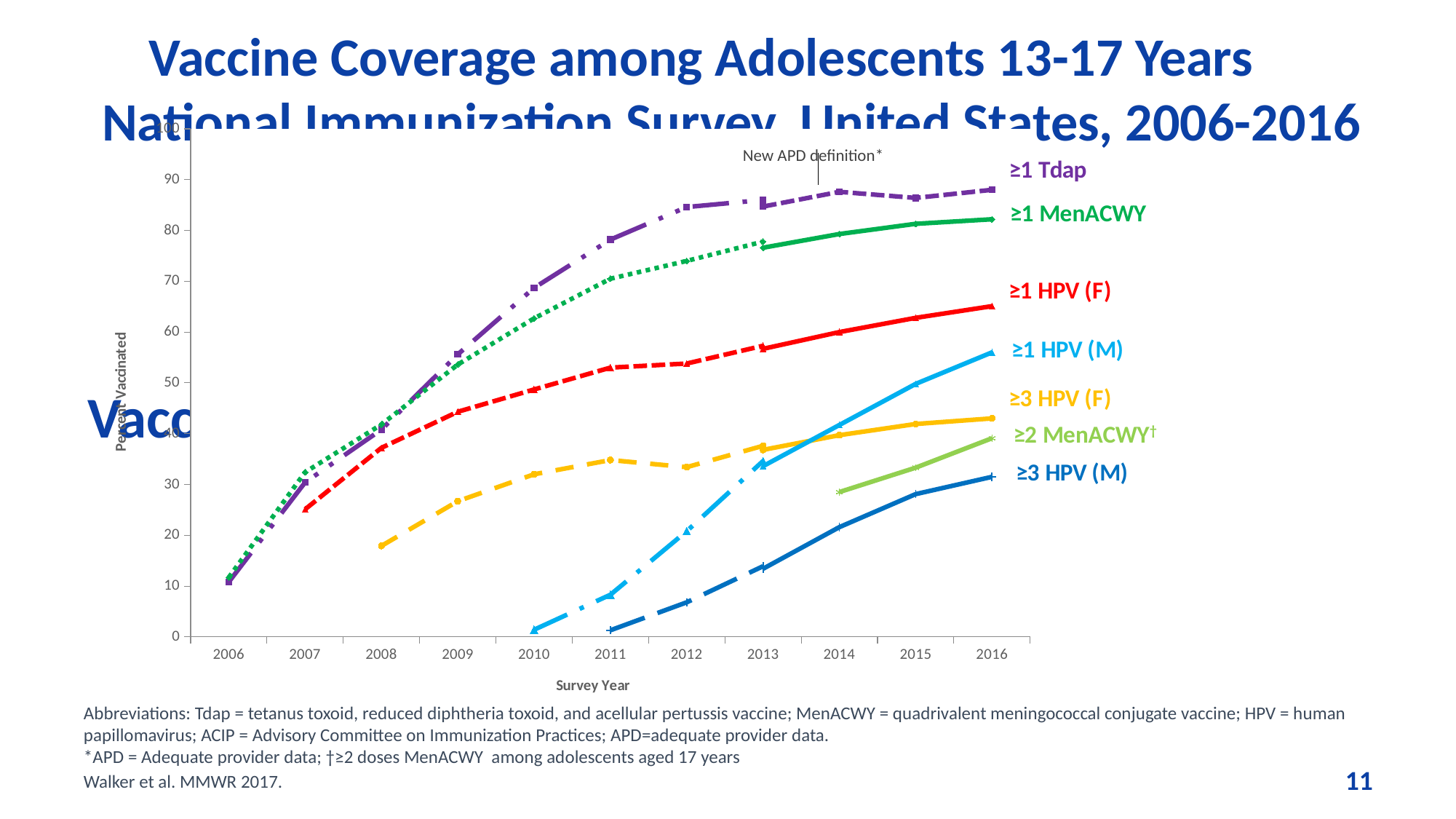
Does the ≥1 Tdap coverage rise or fall from 2006 to 2016? rise How many vaccine series are labelled on the chart? 7 Which series has the lowest coverage in 2016? ≥3 HPV (M) Is the value for ≥3 HPV (M) in 2016 greater or less than 40? less Which series has the highest coverage in 2016? ≥1 Tdap How many survey years are shown on the x axis? 11 In 2016, which is larger: ≥1 MenACWY or ≥1 HPV (F)? ≥1 MenACWY What is the label of the y axis? Percent Vaccinated What kind of chart is shown on the slide? line chart Is the value for ≥1 HPV (F) in 2016 greater or less than 60? greater Is the value for ≥1 HPV (M) in 2010 greater or less than 10? less